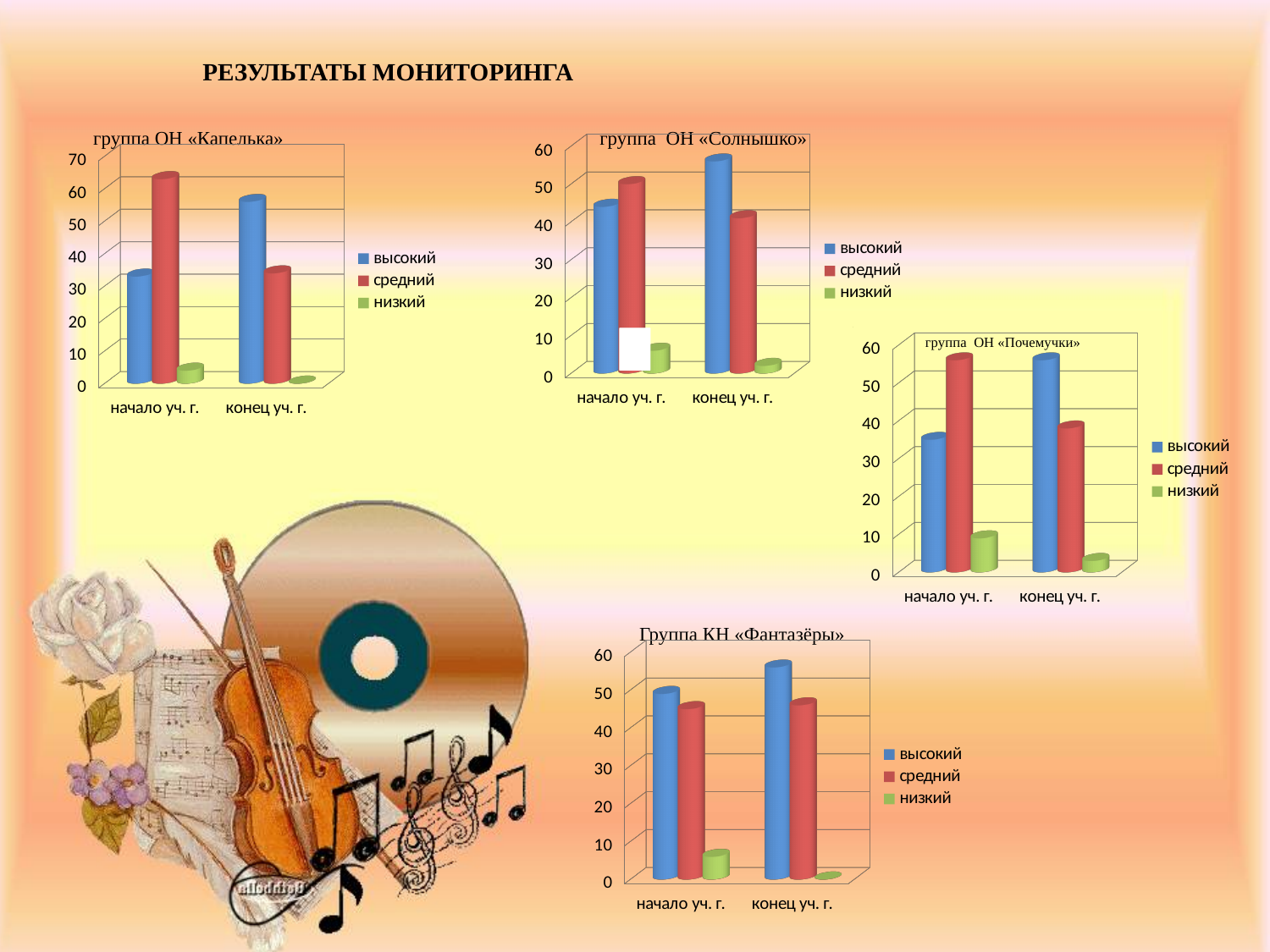
In the «Капелька» chart, is the value for средний at начало уч. г. greater or less than 50? greater In the «Фантазёры» chart, which series has the highest bar at конец уч. г.? высокий How many series does the legend of the «Фантазёры» chart list? 3 In the «Фантазёры» chart, is the value for низкий at начало уч. г. greater or less than 10? less In the «Солнышко» chart, which series has the lowest bar at начало уч. г.? низкий In the «Почемучки» chart, does the средний series rise or fall from начало уч. г. to конец уч. г.? fall What kind of chart is the «Почемучки» chart? bar chart In the «Солнышко» chart, which is larger at начало уч. г.: высокий or средний? средний In the «Почемучки» chart, is the value for высокий at начало уч. г. greater or less than 40? less In the «Капелька» chart, which series has the highest bar at конец уч. г.? высокий In the «Капелька» chart, does the высокий series rise or fall from начало уч. г. to конец уч. г.? rise